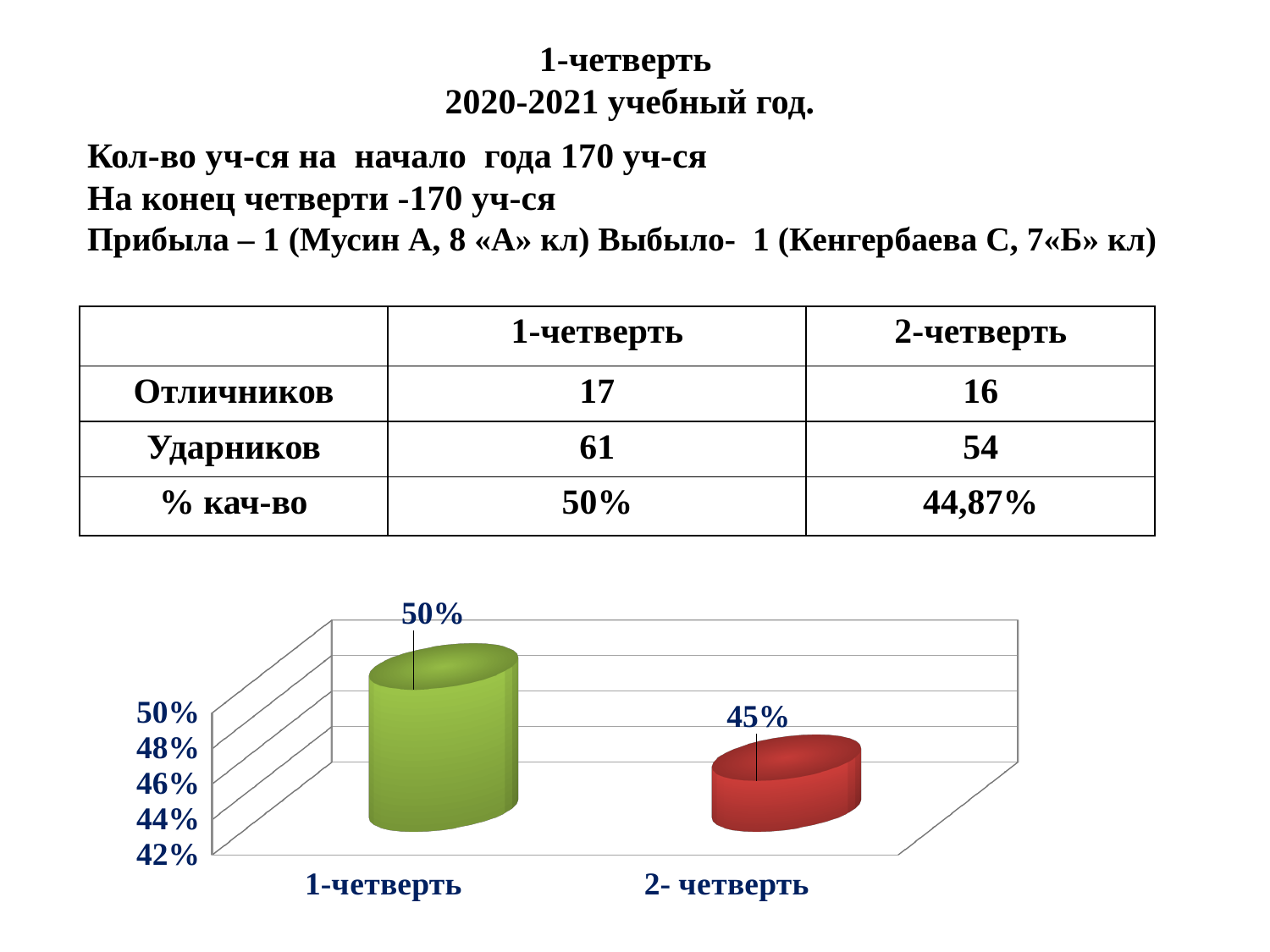
Is the value for 1-четверть greater or less than 46%? greater By how many percentage points does the value for 1-четверть exceed the value for 2- четверть? 5 What is the value shown for 1-четверть in the chart? 50% How many categories are shown on the x axis of the chart? 2 Do the values rise or fall from 1-четверть to 2- четверть? fall Which category has the lowest value in the chart? 2- четверть Which category has the highest value in the chart? 1-четверть Which is larger, the value for 1-четверть or the value for 2- четверть? 1-четверть What colour is the bar for 2- четверть? red What kind of chart is shown on the slide? bar chart Is the value for 2- четверть greater or less than 48%? less What is the value shown for 2- четверть in the chart? 45%